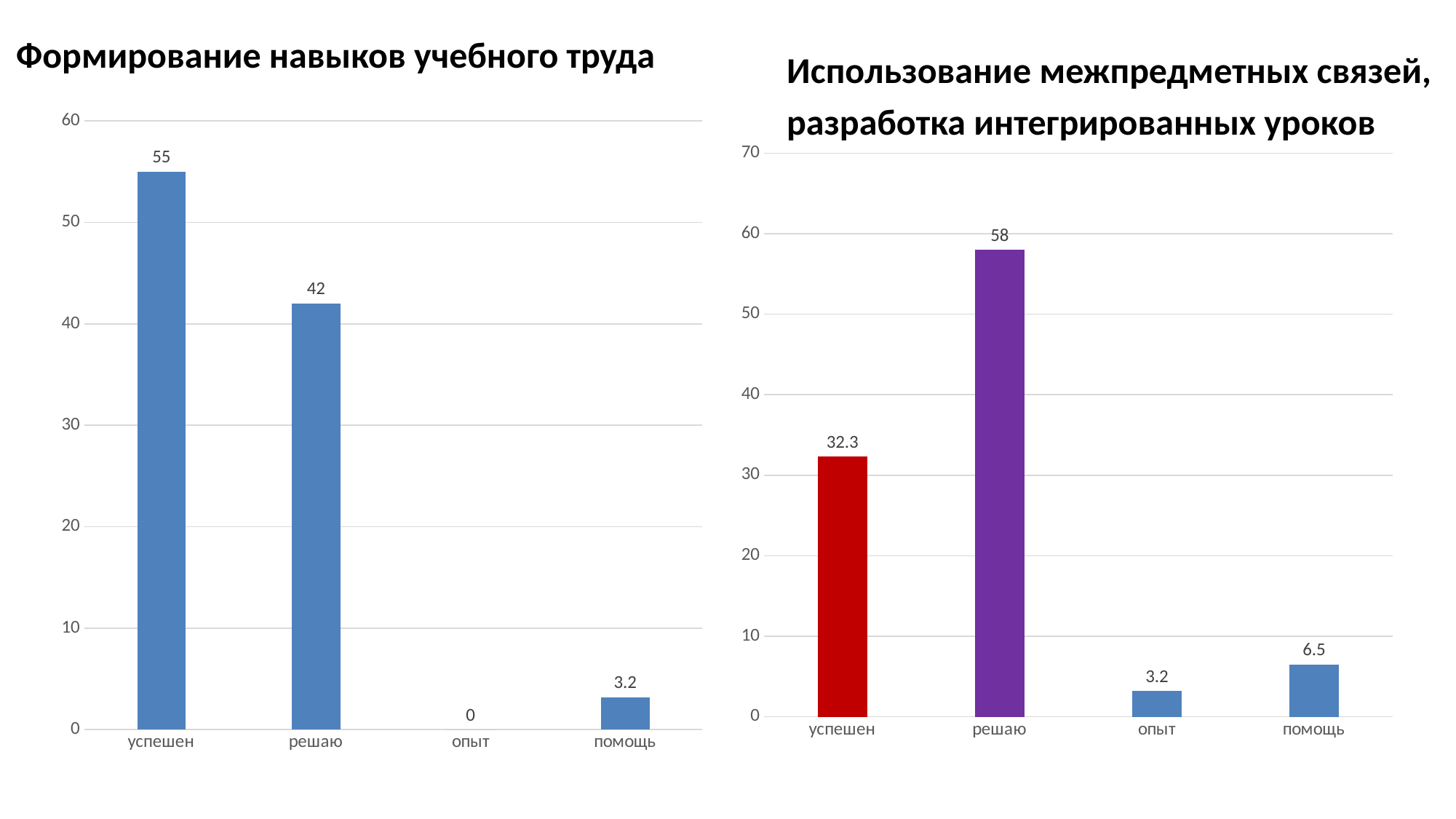
In the chart titled 'Использование межпредметных связей, разработка интегрированных уроков', which is larger, the value for 'опыт' or the value for 'помощь'? помощь In the chart titled 'Использование межпредметных связей, разработка интегрированных уроков', which category has the highest value? решаю In the chart titled 'Формирование навыков учебного труда', what is the value for 'помощь'? 3.2 In the chart titled 'Формирование навыков учебного труда', which category has the lowest value? опыт In the chart titled 'Использование межпредметных связей, разработка интегрированных уроков', what is the value for 'помощь'? 6.5 In the chart titled 'Формирование навыков учебного труда', what is the value for 'успешен'? 55 In the chart titled 'Формирование навыков учебного труда', what is the difference between the values for 'успешен' and 'решаю'? 13 In the chart titled 'Использование межпредметных связей, разработка интегрированных уроков', what colour is the bar for 'решаю'? purple In the chart titled 'Использование межпредметных связей, разработка интегрированных уроков', what is the difference between the values for 'решаю' and 'успешен'? 25.7 In the chart titled 'Использование межпредметных связей, разработка интегрированных уроков', what is the value for 'успешен'? 32.3 In the chart titled 'Формирование навыков учебного труда', how many categories are shown on the x axis? 4 What kind of chart is the chart on the right side of the slide? bar chart